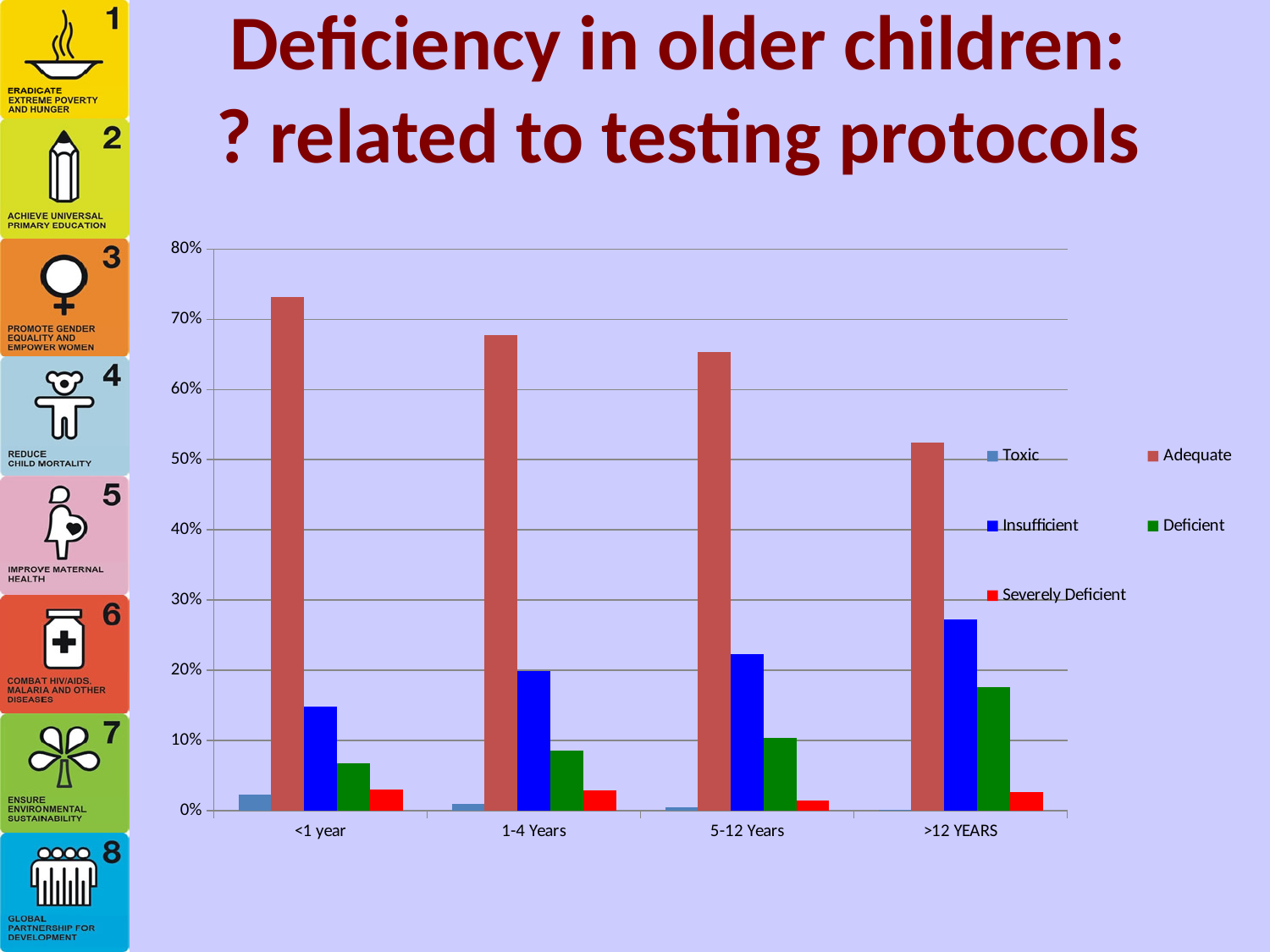
How many series does the legend list? 5 Is the Adequate value for <1 year greater or less than 70%? greater Does the Adequate value rise or fall across the age groups from <1 year to >12 YEARS? fall Is the Adequate value for >12 YEARS greater or less than 50%? greater What kind of chart is shown on the slide? bar chart Is the Insufficient value for >12 YEARS greater or less than 20%? greater How many age groups are shown on the x axis? 4 For which age group is the Adequate value highest? <1 year For which age group is the Insufficient value highest? >12 YEARS For >12 YEARS, which is larger: the Insufficient value or the Deficient value? Insufficient